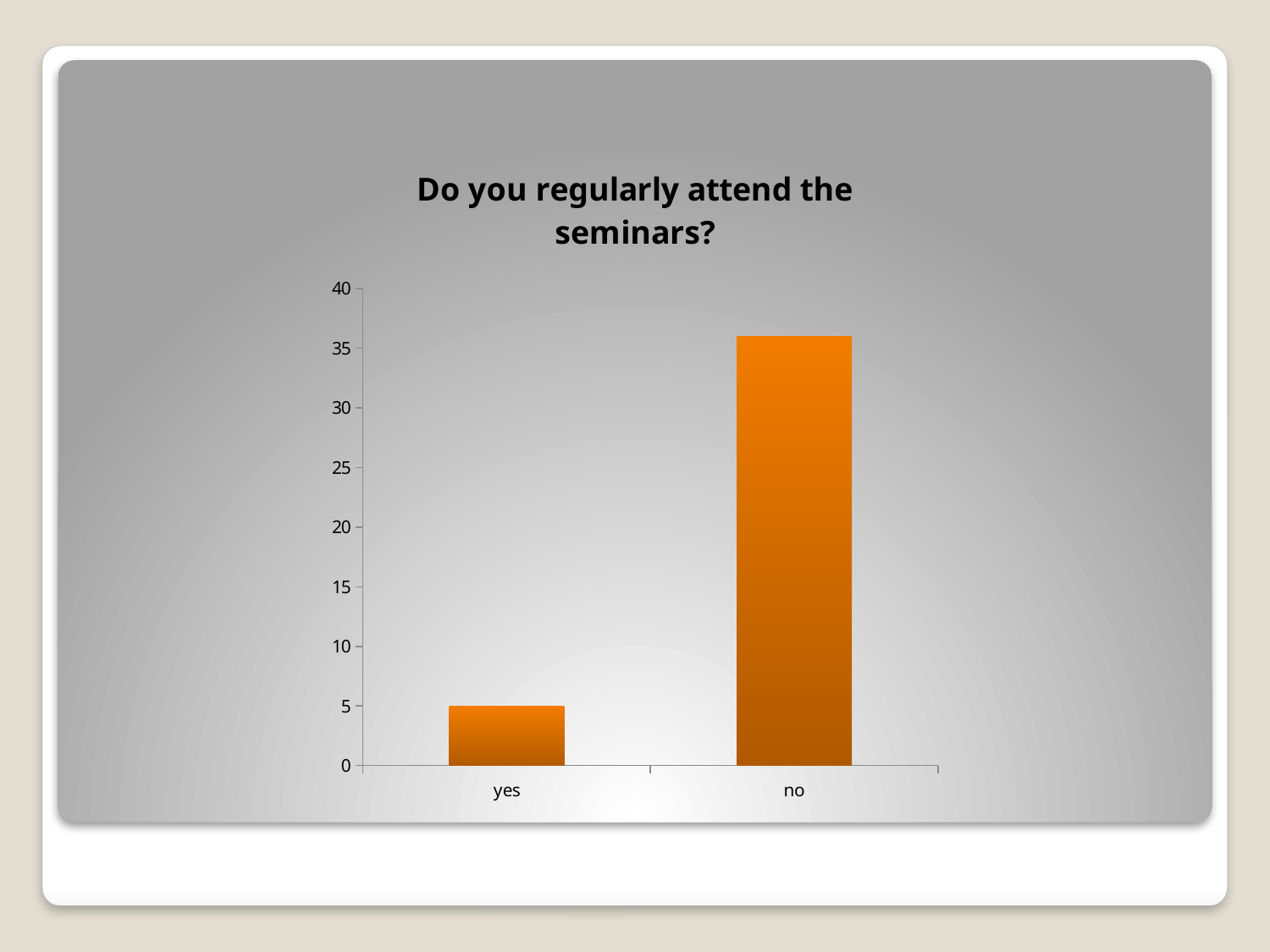
What kind of chart is shown on the slide? bar chart How many categories are shown on the x axis? 2 Which category has the lowest value? yes Is the value for "yes" greater or less than 10? less What is the highest value shown on the y axis? 40 Is the value for "no" greater or less than 35? greater What is the value for "yes"? 5 Is the value for "no" greater or less than 40? less Which is larger, the value for "yes" or the value for "no"? no What is the title of the chart? Do you regularly attend the seminars? Which category has the highest value? no